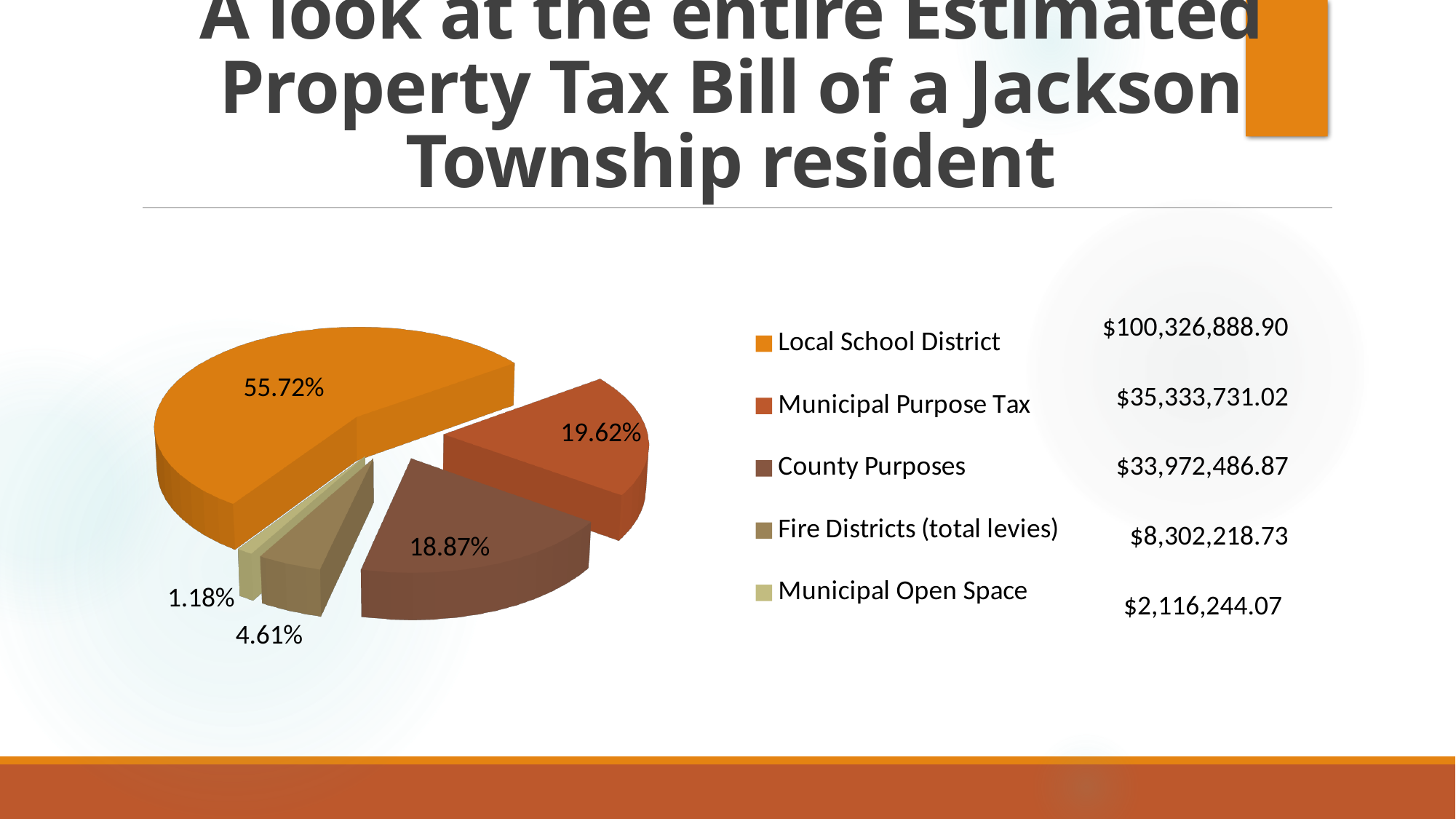
Which category has the largest slice of the pie? Local School District What is the difference in percentage points between the Local School District slice and the Municipal Purpose Tax slice? 36.10% What dollar amount is shown next to County Purposes? $33,972,486.87 What share of the pie does County Purposes represent? 18.87% What share of the pie does Fire Districts (total levies) represent? 4.61% What share of the pie does Municipal Purpose Tax represent? 19.62% What kind of chart is shown on the slide? pie chart How many entries does the legend list? 5 Which category has the smallest slice of the pie? Municipal Open Space How many slices does the pie chart have? 5